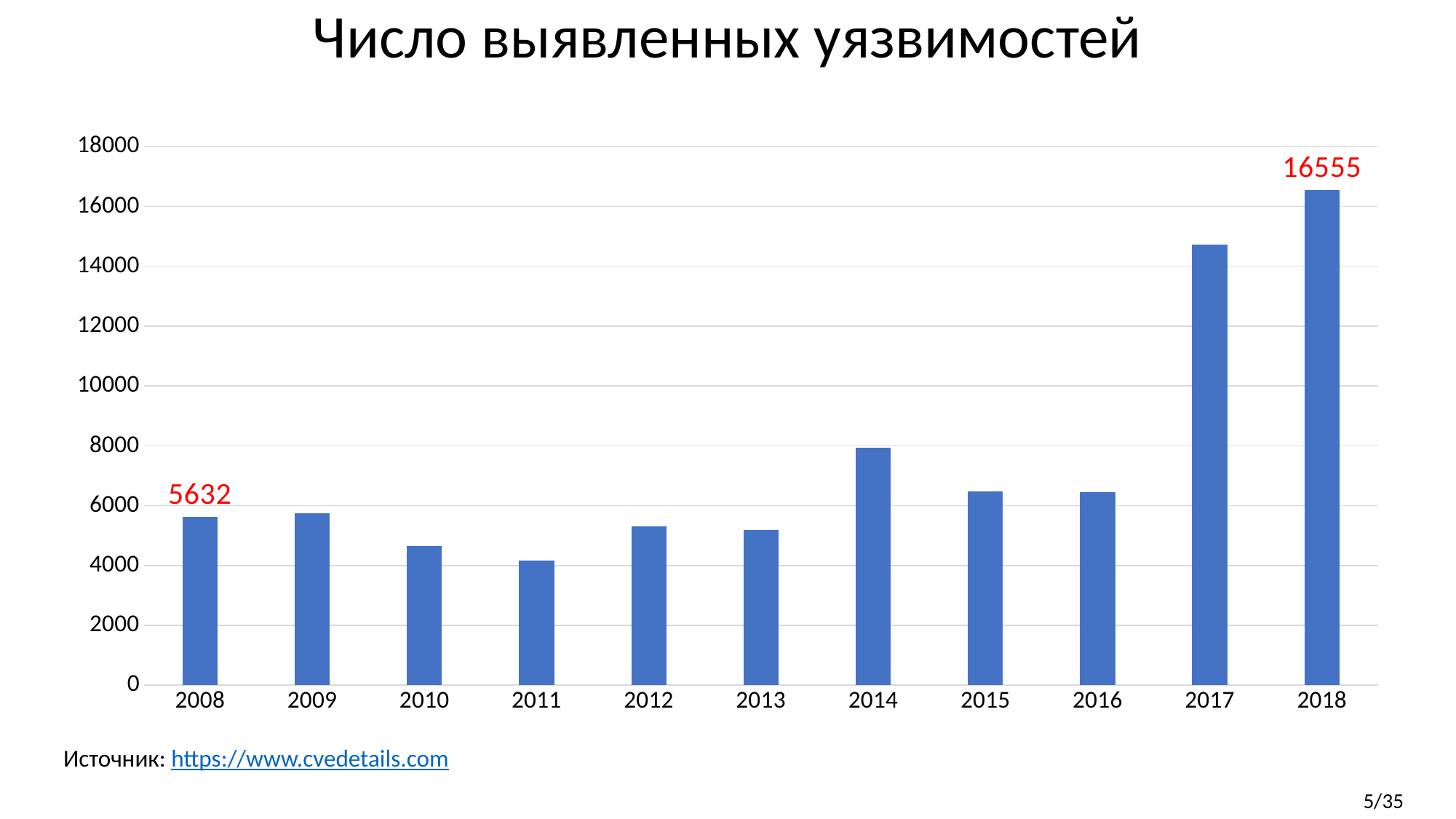
Which is larger, the value for 2014 or the value for 2015? 2014 What is the value for 2008? 5632 How many years are shown on the x axis? 11 Is the value for 2011 greater or less than 5000? less Which year has the lowest value? 2011 What kind of chart is shown on the slide? bar chart Do the values rise or fall from 2016 to 2018? rise Is the value for 2017 greater or less than 14000? greater What is the value for 2018? 16555 What is the title of the chart? Число выявленных уязвимостей Which year has the highest value? 2018 What is the difference between the values for 2018 and 2008? 10923